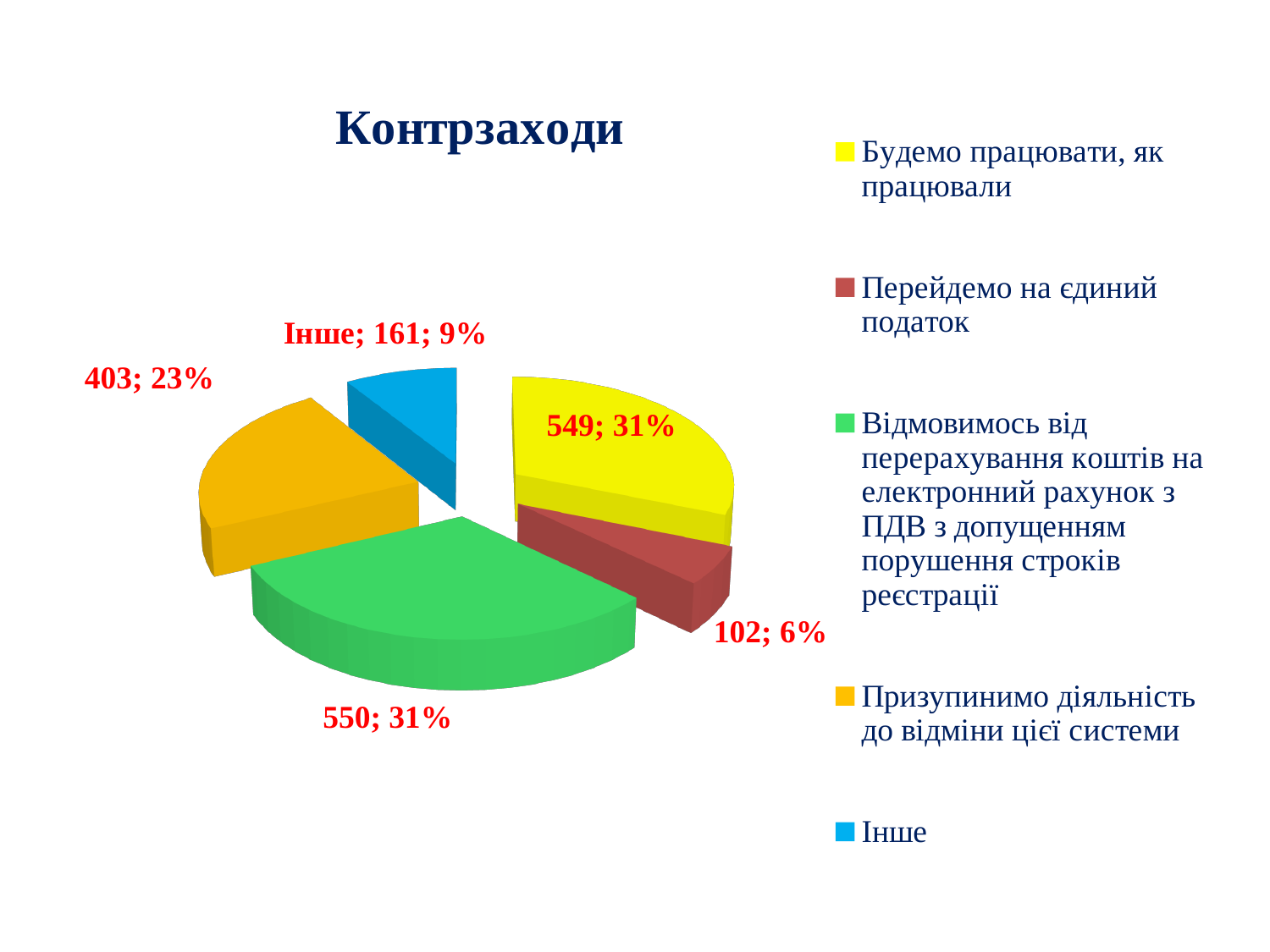
What colour is the slice for "Інше"? blue What type of chart is shown on the slide? pie chart Which is larger: the value for "Призупинимо діяльність до відміни цієї системи" or the value for "Перейдемо на єдиний податок"? Призупинимо діяльність до відміни цієї системи What share of the pie does "Інше" represent? 9% What is the value for "Призупинимо діяльність до відміни цієї системи"? 403 What is the title of the chart? Контрзаходи What is the difference between the values for "Призупинимо діяльність до відміни цієї системи" and "Інше"? 242 Which category has the smallest slice? Перейдемо на єдиний податок How many slices does the pie chart have? 5 What is the value for "Інше"? 161 What is the value for "Перейдемо на єдиний податок"? 102 What share of the pie does "Будемо працювати, як працювали" represent? 31%